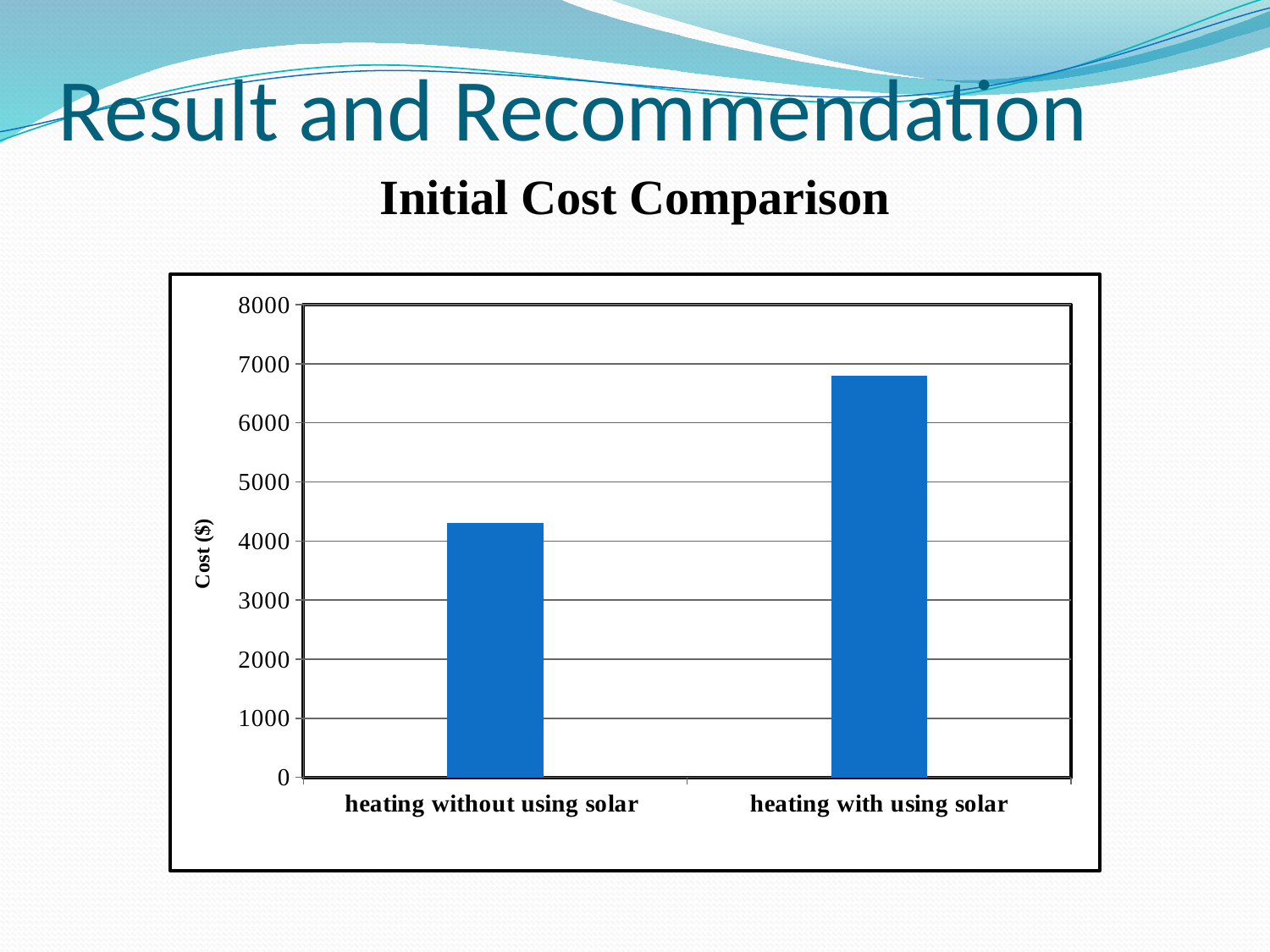
Is the value for heating with using solar greater or less than 7000? less What kind of chart is shown on the slide? bar chart Is the value for heating without using solar greater or less than 4000? greater What is the label of the vertical axis? Cost ($) Which category has the highest cost? heating with using solar Is the value for heating with using solar greater or less than 6000? greater Which category has the lowest cost? heating without using solar How many bars are plotted in the chart? 2 What is the title of the chart? Initial Cost Comparison Which is larger, the cost for heating with using solar or heating without using solar? heating with using solar